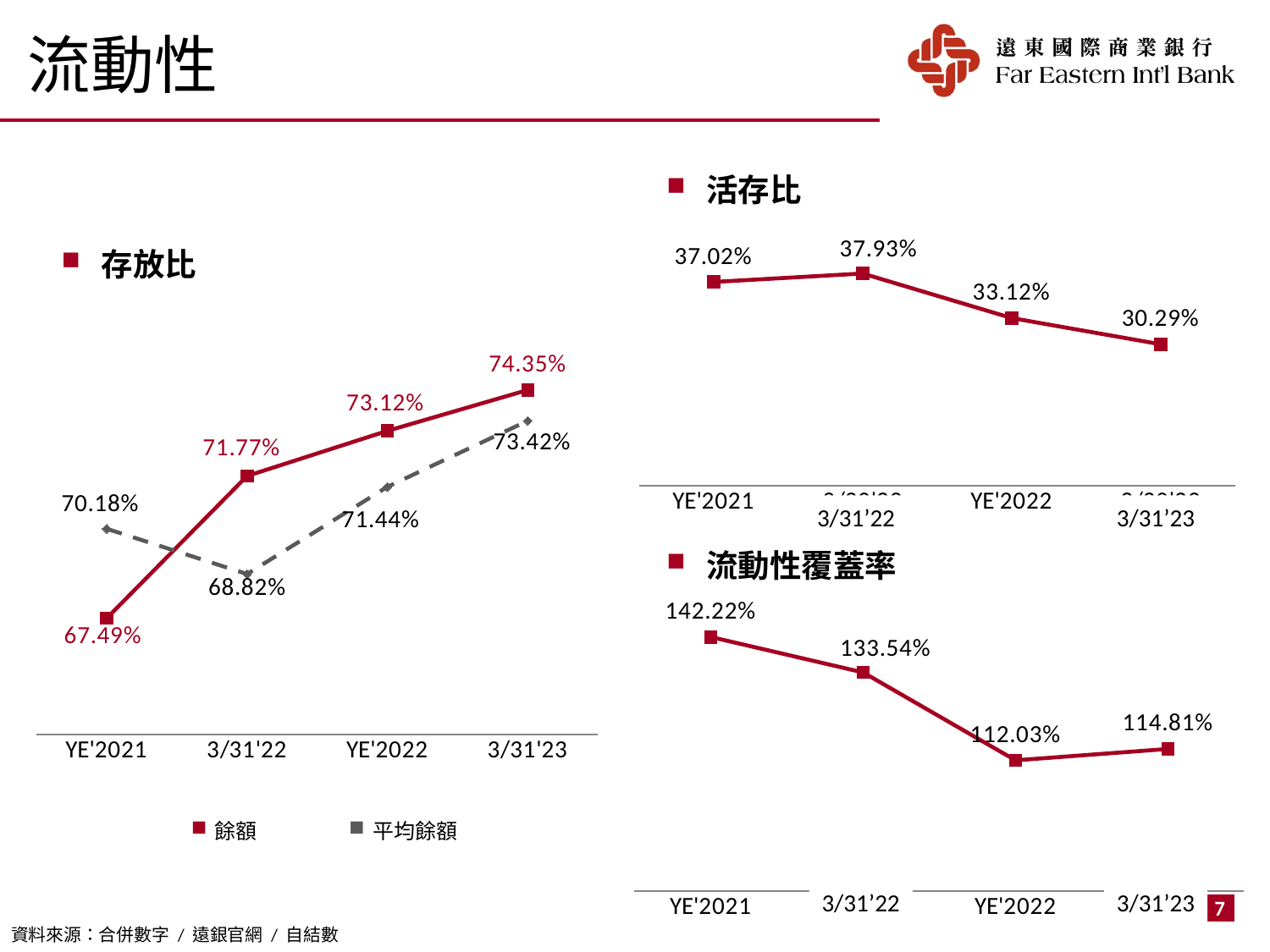
In the 存放比 chart, what is the 餘額 value for YE'2021? 67.49% In the 存放比 chart, does the 餘額 series rise or fall from YE'2021 to 3/31'23? rise In the 活存比 chart, what is the value for 3/31'22? 37.93% In the 存放比 chart, which period has the highest 餘額 value? 3/31'23 In the 流動性覆蓋率 chart, which is larger, the value for YE'2022 or the value for 3/31'23? 3/31'23 In the 存放比 chart, how many series does the legend list? 2 In the 活存比 chart, what is the difference between the YE'2021 and YE'2022 values? 3.90% In the 存放比 chart, what is the 平均餘額 value for 3/31'22? 68.82% In the 存放比 chart, what is the difference between the 餘額 and 平均餘額 values at YE'2022? 1.68% In the 流動性覆蓋率 chart, what is the value for YE'2021? 142.22% In the 活存比 chart, which period has the lowest value? 3/31'23 What kind of chart is the 流動性覆蓋率 chart? line chart